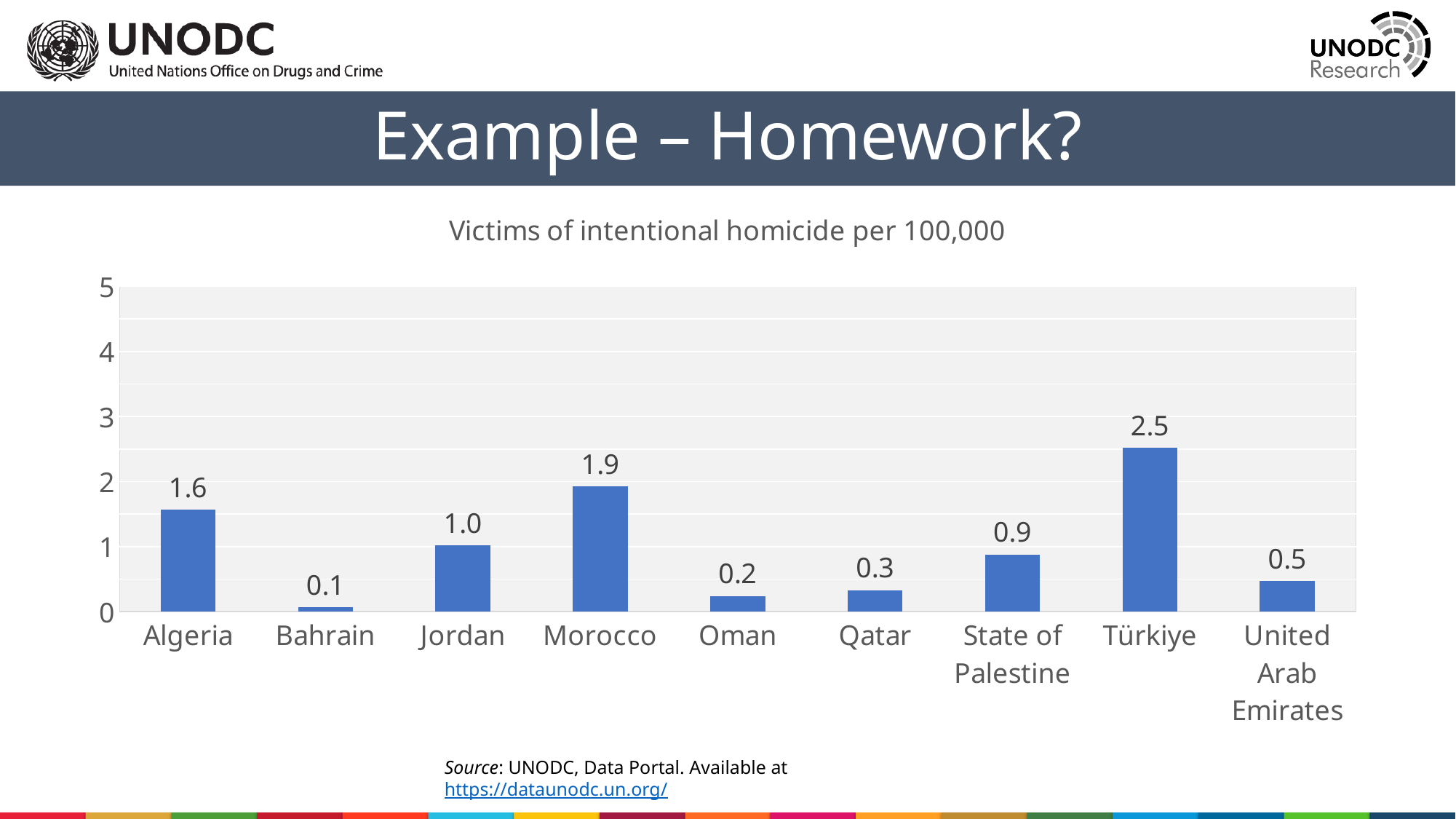
Which is larger, the value for Jordan or the value for Qatar? Jordan What is the title of the chart? Victims of intentional homicide per 100,000 What is the difference between the values for Türkiye and Algeria? 0.9 What kind of chart is shown? bar chart What is the value for State of Palestine? 0.9 What is the value for Morocco? 1.9 Which country has the lowest value? Bahrain Which country has the highest value? Türkiye How many countries are shown on the chart? 9 What is the value for Oman? 0.2 Is the value for Morocco greater or less than 1? greater What is the value for United Arab Emirates? 0.5